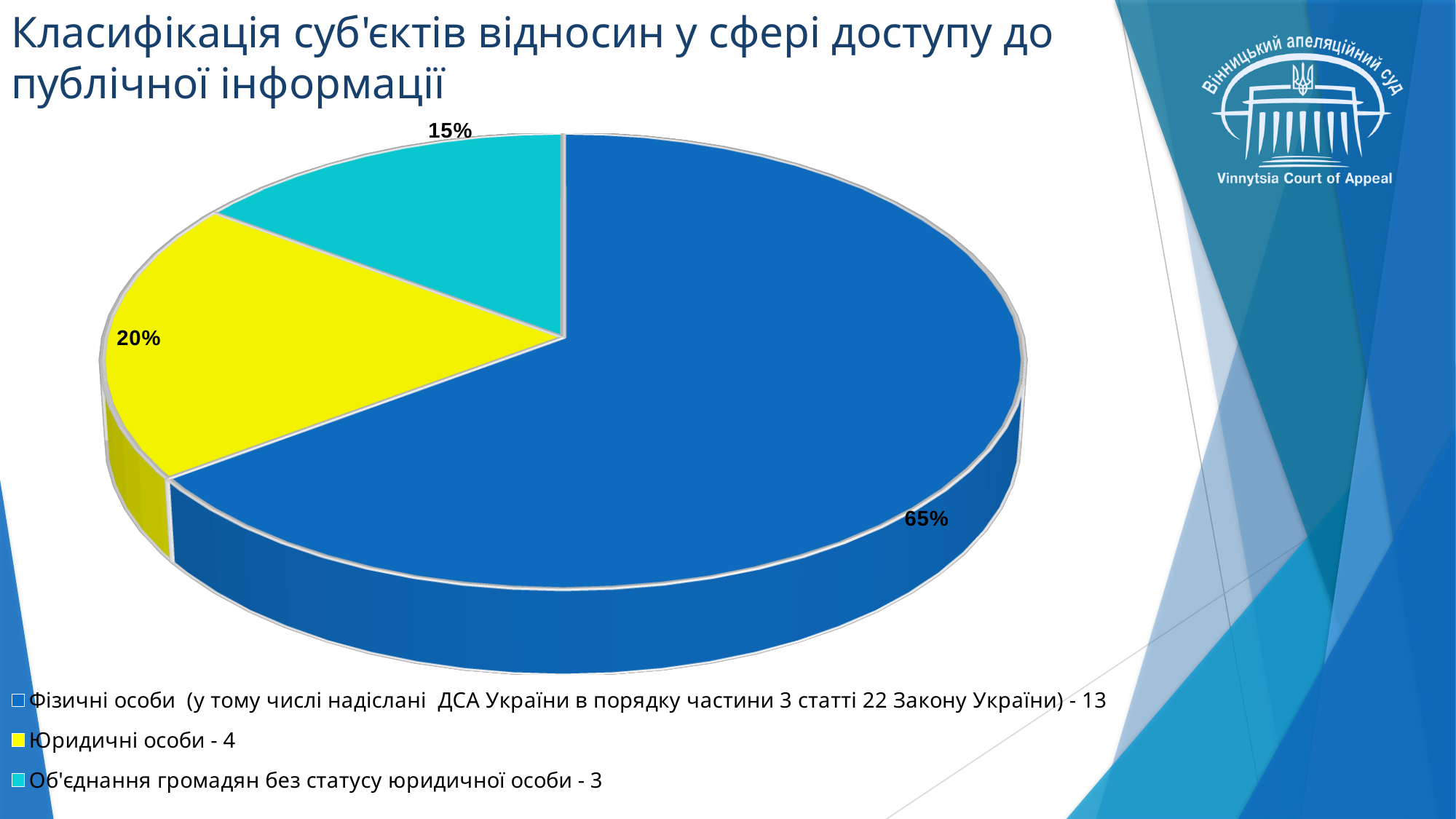
What percentage share does the slice for "Юридичні особи" have? 20% What percentage share does the slice for "Фізичні особи" have? 65% What colour is the slice for "Об'єднання громадян без статусу юридичної особи"? Cyan Which category has the smallest slice of the pie? Об'єднання громадян без статусу юридичної особи What kind of chart is shown on the slide? Pie chart What is the difference in percentage points between the "Фізичні особи" slice and the "Юридичні особи" slice? 45 Which slice is larger: "Юридичні особи" or "Об'єднання громадян без статусу юридичної особи"? Юридичні особи What percentage share does the slice for "Об'єднання громадян без статусу юридичної особи" have? 15% How many entries does the legend list? 3 What number is given in the legend for "Юридичні особи"? 4 How many slices does the pie chart have? 3 Which category has the largest slice of the pie? Фізичні особи